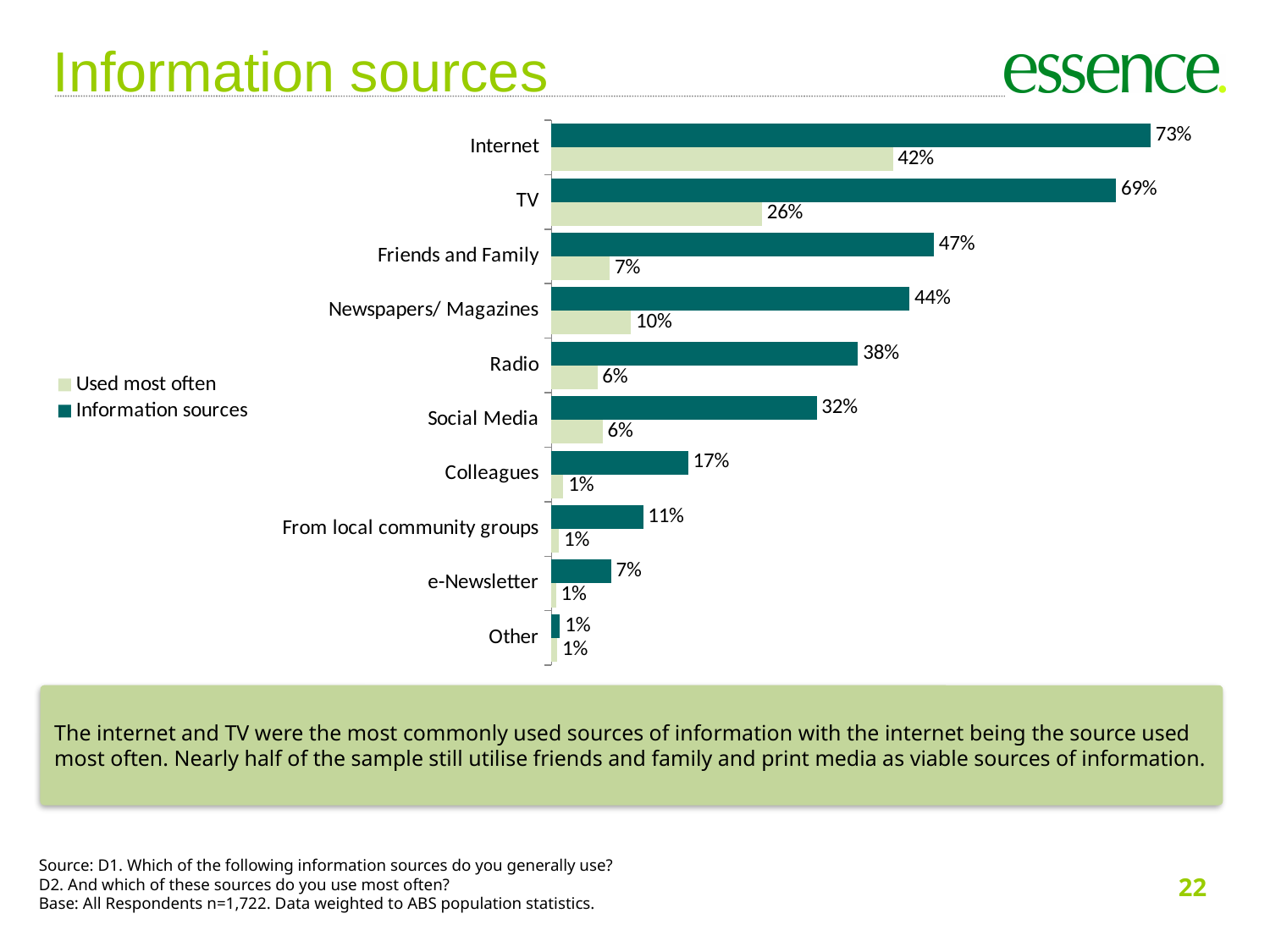
What kind of chart is shown on the slide? Bar chart Which category has the lowest 'Information sources' value? Other What is the 'Used most often' value for TV? 26% What is the 'Used most often' value for Social Media? 6% Which is larger: the 'Information sources' value for Radio or for Social Media? Radio How many series does the legend list? 2 How many categories are shown on the chart? 10 What is the 'Information sources' value for Internet? 73% Which category has the highest 'Information sources' value? Internet What is the title of the slide? Information sources What is the difference between the 'Information sources' and 'Used most often' values for Internet? 31% What is the 'Information sources' value for Newspapers/ Magazines? 44%